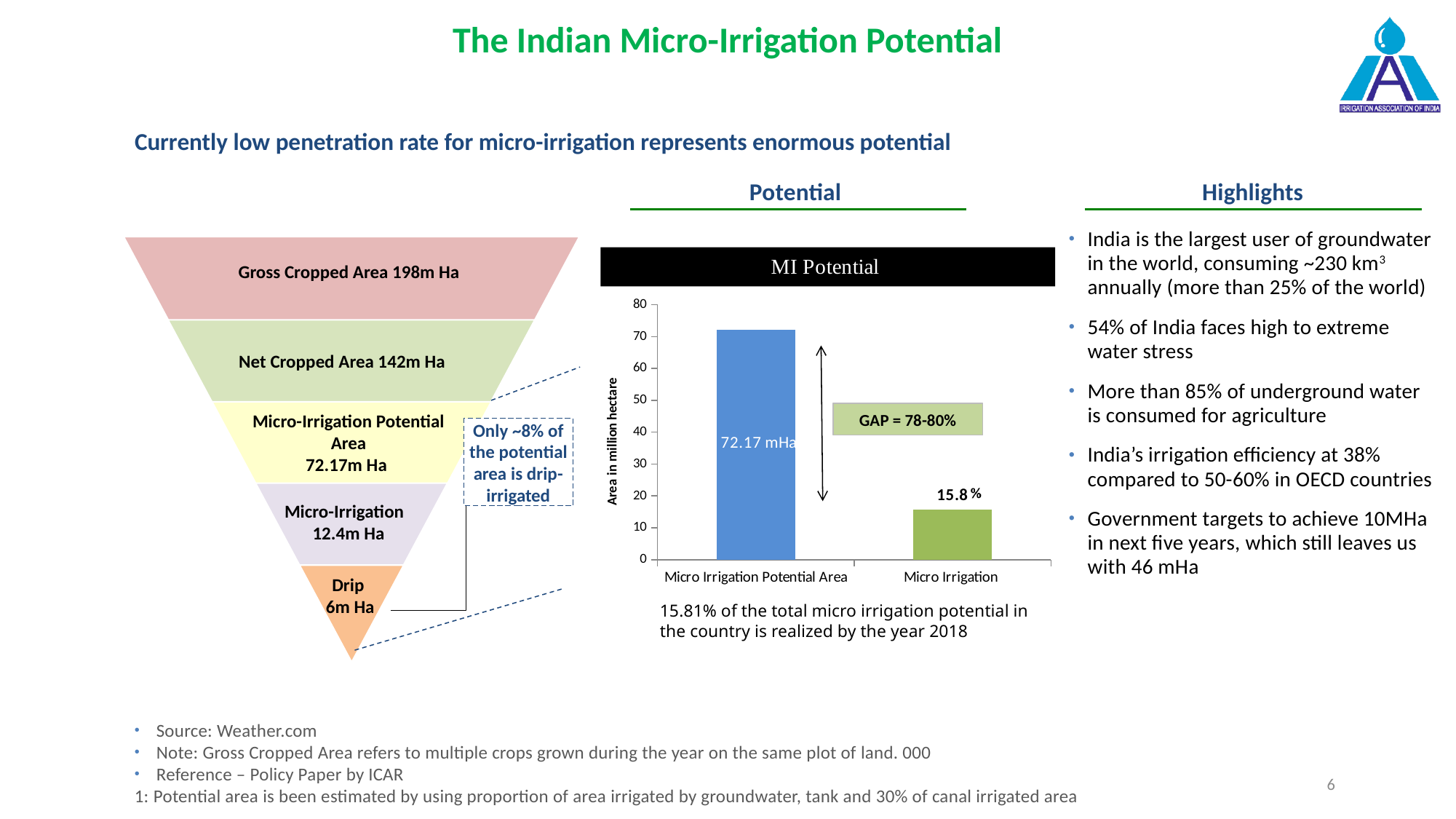
Which category has the lowest bar in the MI Potential chart? Micro Irrigation What does the gap annotation between the two bars in the MI Potential chart say? GAP = 78-80% What is the y-axis label of the MI Potential chart? Area in million hectare In the MI Potential chart, is the value for Micro Irrigation greater or less than 20? less In the MI Potential chart, which is larger: Micro Irrigation Potential Area or Micro Irrigation? Micro Irrigation Potential Area What kind of chart is the MI Potential chart? bar chart In the MI Potential chart, is the value for Micro Irrigation greater or less than 10? greater In the MI Potential chart, is the value for Micro Irrigation Potential Area greater or less than 70? greater In the MI Potential chart, what percentage label is printed above the Micro Irrigation bar? 15.8% In the MI Potential chart, what value is labelled on the Micro Irrigation Potential Area bar? 72.17 mHa How many categories are shown on the x axis of the MI Potential chart? 2 Which category has the highest bar in the MI Potential chart? Micro Irrigation Potential Area